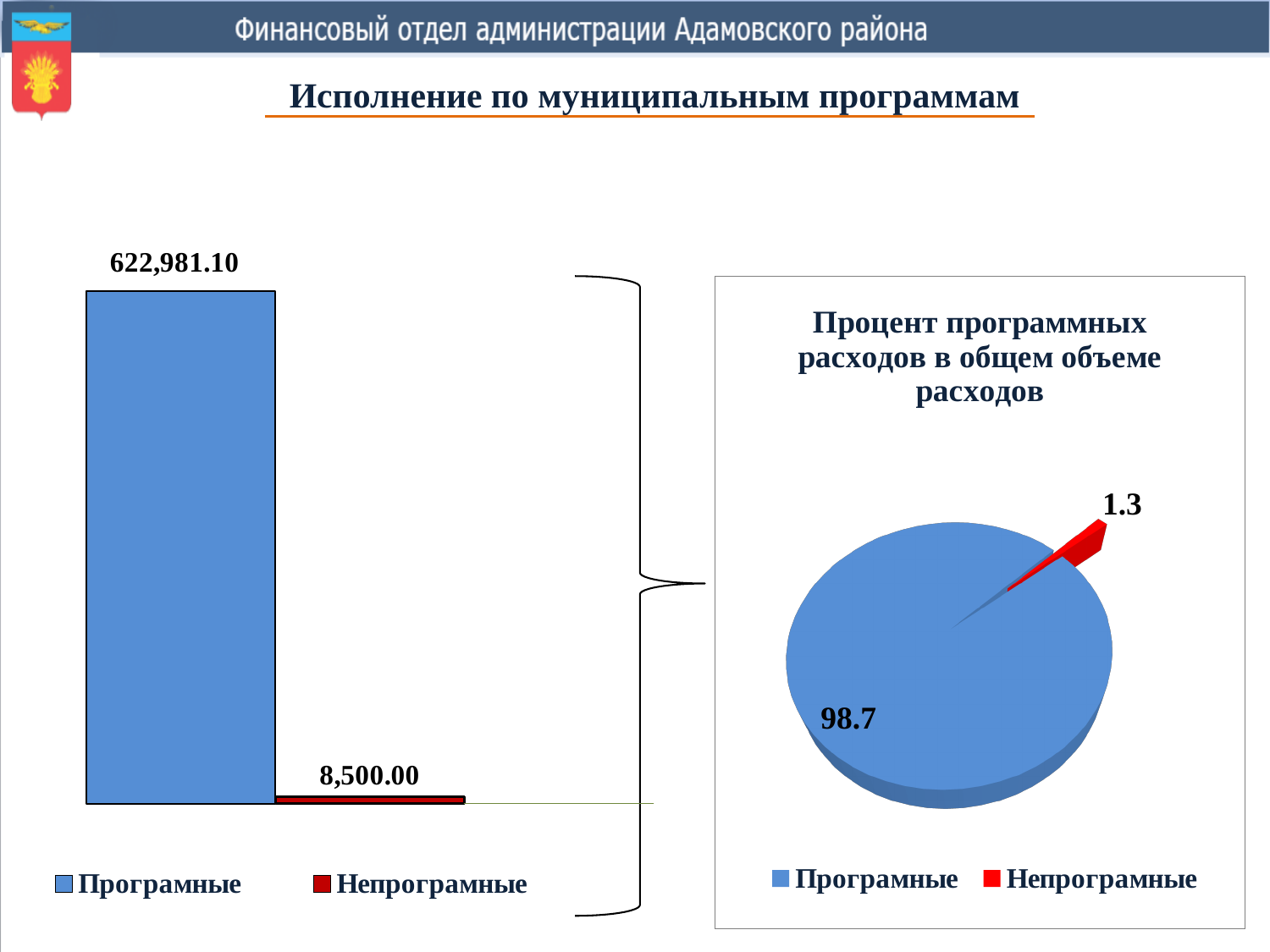
In the bar chart on the left, what is the value for Програмные? 622,981.10 In the pie chart 'Процент программных расходов в общем объеме расходов', what share does Непрограмные have? 1.3 What kind of chart is shown on the left side of the slide? Bar chart In the bar chart on the left, what is the difference between the values for Програмные and Непрограмные? 614,481.10 In the bar chart on the left, which is larger: Програмные or Непрограмные? Програмные What is the title of the chart on the right side of the slide? Процент программных расходов в общем объеме расходов In the bar chart on the left, what is the value for Непрограмные? 8,500.00 In the bar chart on the left, which category has the highest value? Програмные In the pie chart 'Процент программных расходов в общем объеме расходов', what share does Програмные have? 98.7 How many series does the legend of the bar chart on the left list? 2 What kind of chart is shown on the right side of the slide? Pie chart In the bar chart on the left, which category has the lowest value? Непрограмные